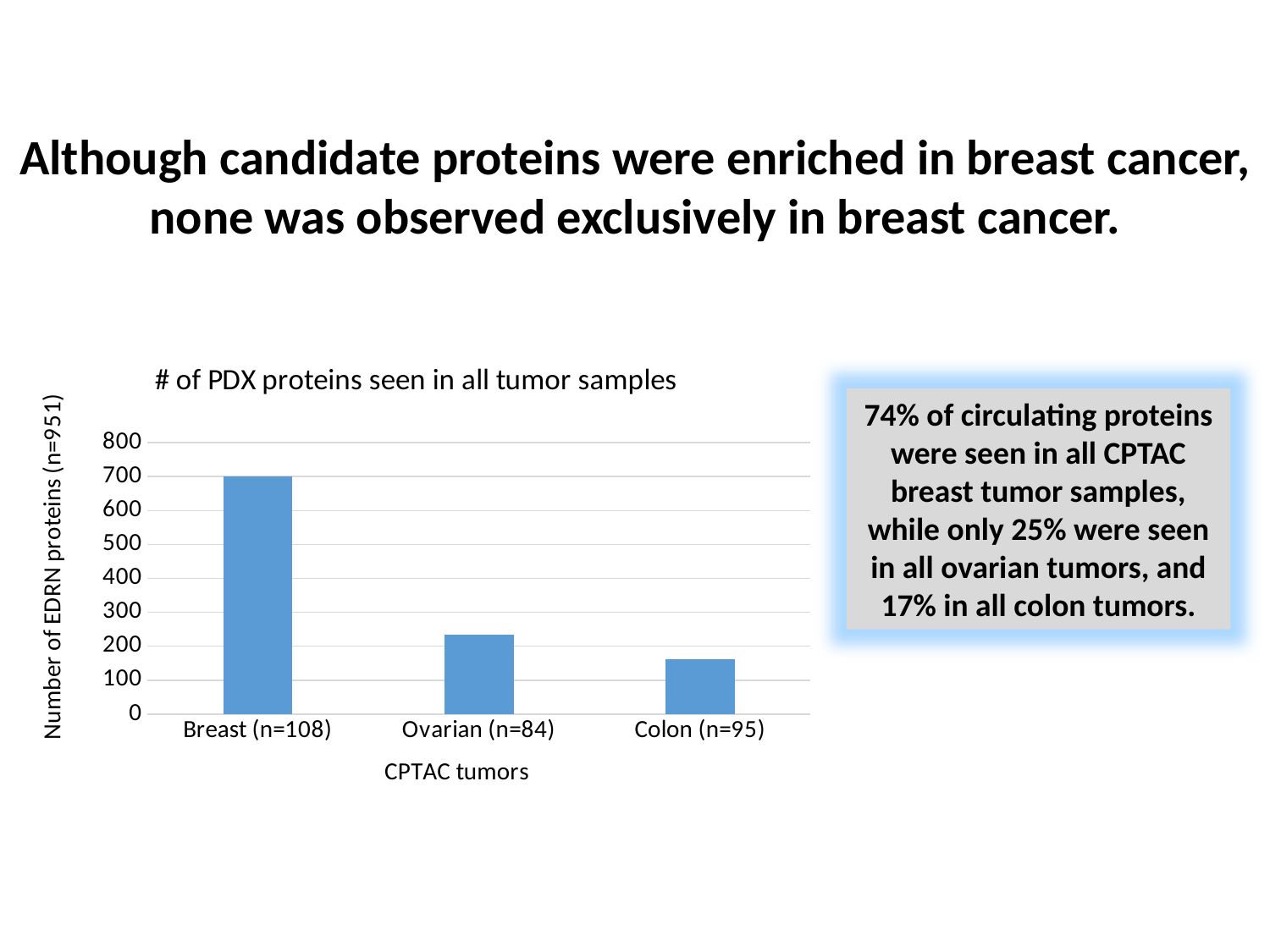
Is the value for Colon (n=95) greater or less than 100? greater What is the title of the chart? # of PDX proteins seen in all tumor samples Which category has the highest bar in the chart? Breast (n=108) What is the label of the y axis of the chart? Number of EDRN proteins (n=951) Is the value for Ovarian (n=84) greater or less than 200? greater How many categories are plotted on the x axis of the chart? 3 Which category has the lowest bar in the chart? Colon (n=95) Do the bar values rise or fall from left to right along the x axis? fall What type of chart is shown on the slide? bar chart Is the value for Breast (n=108) greater or less than 600? greater Which is larger, the value for Ovarian (n=84) or the value for Colon (n=95)? Ovarian (n=84)